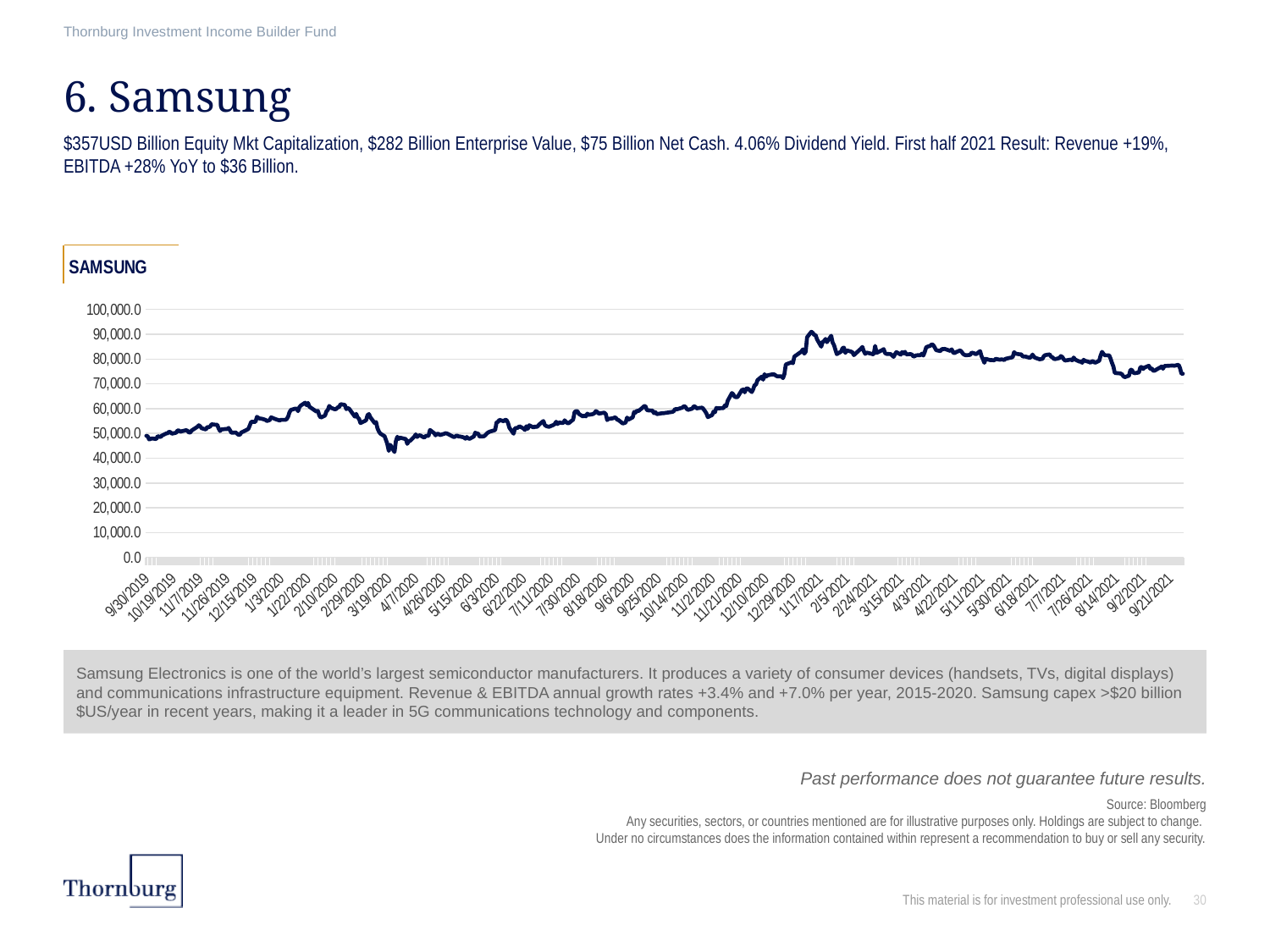
Is the value at 9/30/2019 greater or less than 40,000? greater Is the value at 1/17/2021 greater or less than 80,000? greater What is the title of the chart? SAMSUNG Is the value at 9/21/2021 greater or less than 80,000? less What kind of chart is shown on the slide? line chart What is the highest value shown on the chart's vertical axis? 100,000.0 Which is larger, the value at 4/7/2020 or the value at 1/17/2021? 1/17/2021 Overall, does the line rise or fall from 9/30/2019 to 9/21/2021? rise Which is larger, the value at 9/30/2019 or the value at 9/21/2021? 9/21/2021